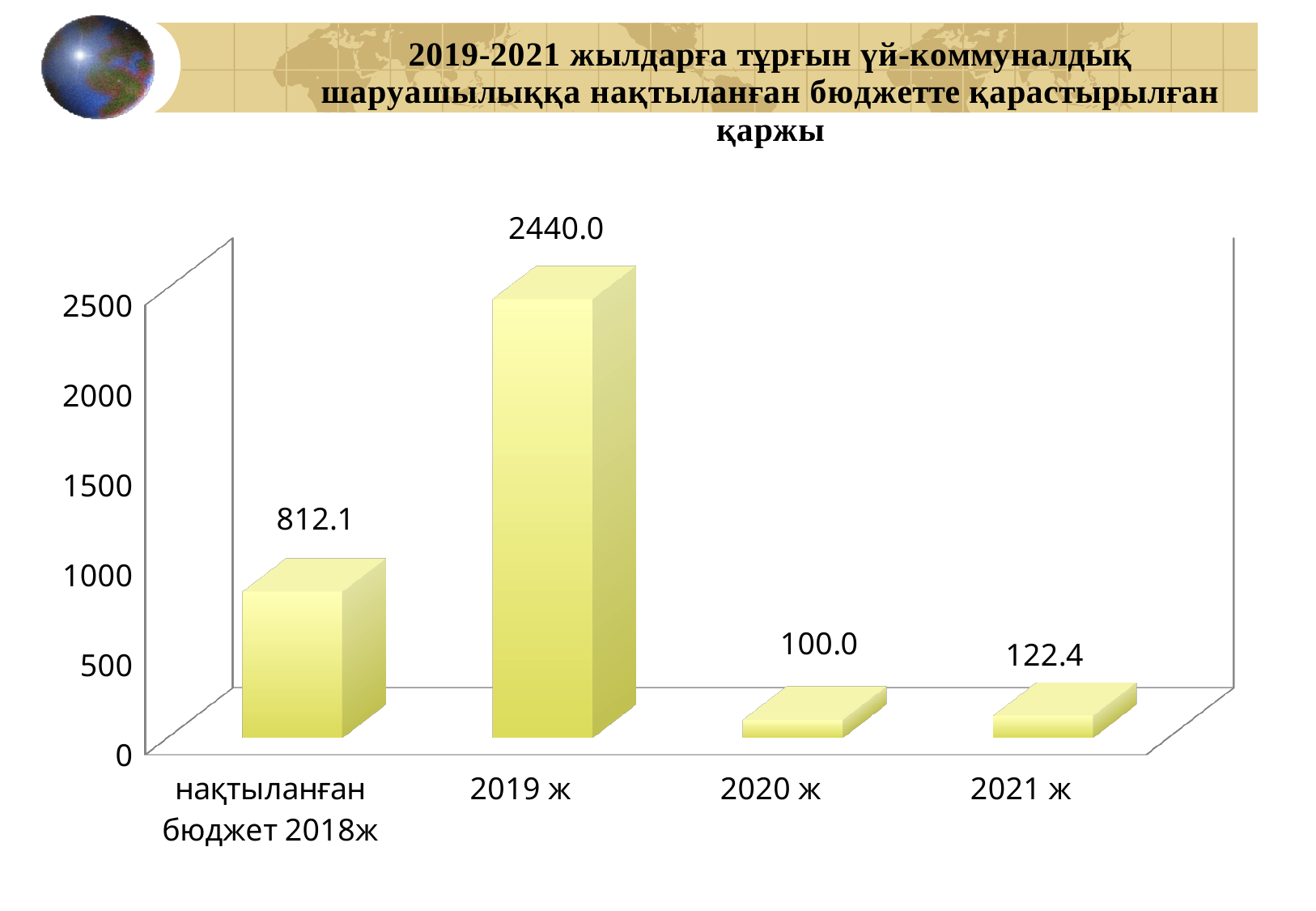
What is the value for нақтыланған бюджет 2018ж? 812.1 Which category has the lowest value? 2020 ж Which category has the highest value? 2019 ж How many categories are shown on the chart? 4 What is the value for 2021 ж? 122.4 What is the difference between the values for 2019 ж and нақтыланған бюджет 2018ж? 1627.9 What is the value for 2019 ж? 2440.0 What is the difference between the values for 2021 ж and 2020 ж? 22.4 Is the value for 2019 ж greater or less than 2000? greater What kind of chart is shown on the slide? bar chart What is the value for 2020 ж? 100.0 Which is larger, the value for нақтыланған бюджет 2018ж or the value for 2021 ж? нақтыланған бюджет 2018ж